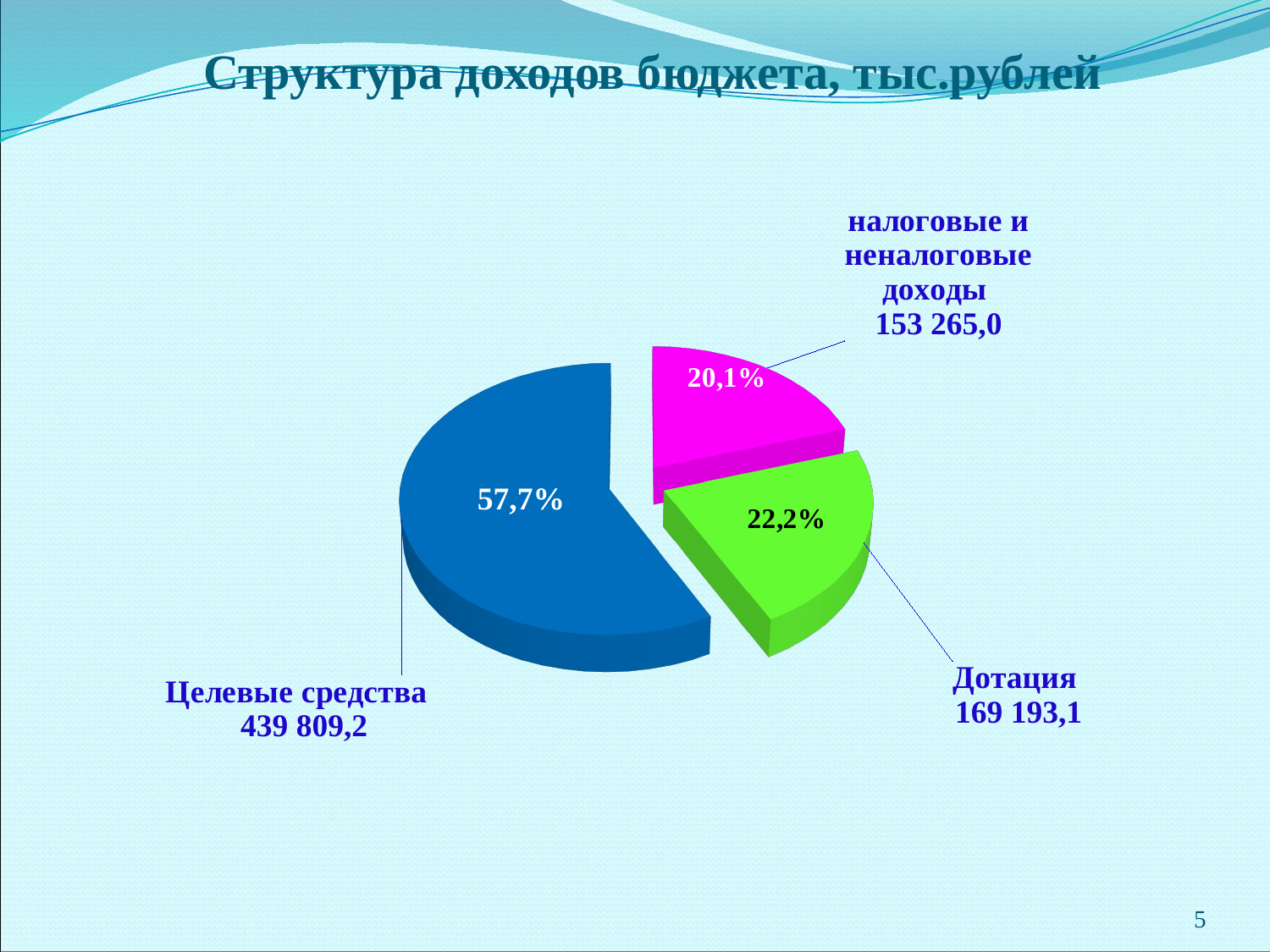
What is the value for Целевые средства? 439 809,2 Which category has the largest slice? Целевые средства What is the title of the chart? Структура доходов бюджета, тыс.рублей What share of the pie does налоговые и неналоговые доходы represent? 20,1% What is the value for налоговые и неналоговые доходы? 153 265,0 What kind of chart is shown on the slide? Pie chart Which category has the smallest slice? налоговые и неналоговые доходы What is the value for Дотация? 169 193,1 How many slices does the pie chart have? 3 What share of the pie does Дотация represent? 22,2% What share of the pie does Целевые средства represent? 57,7% What is the difference between the values for Целевые средства and Дотация? 270 616,1